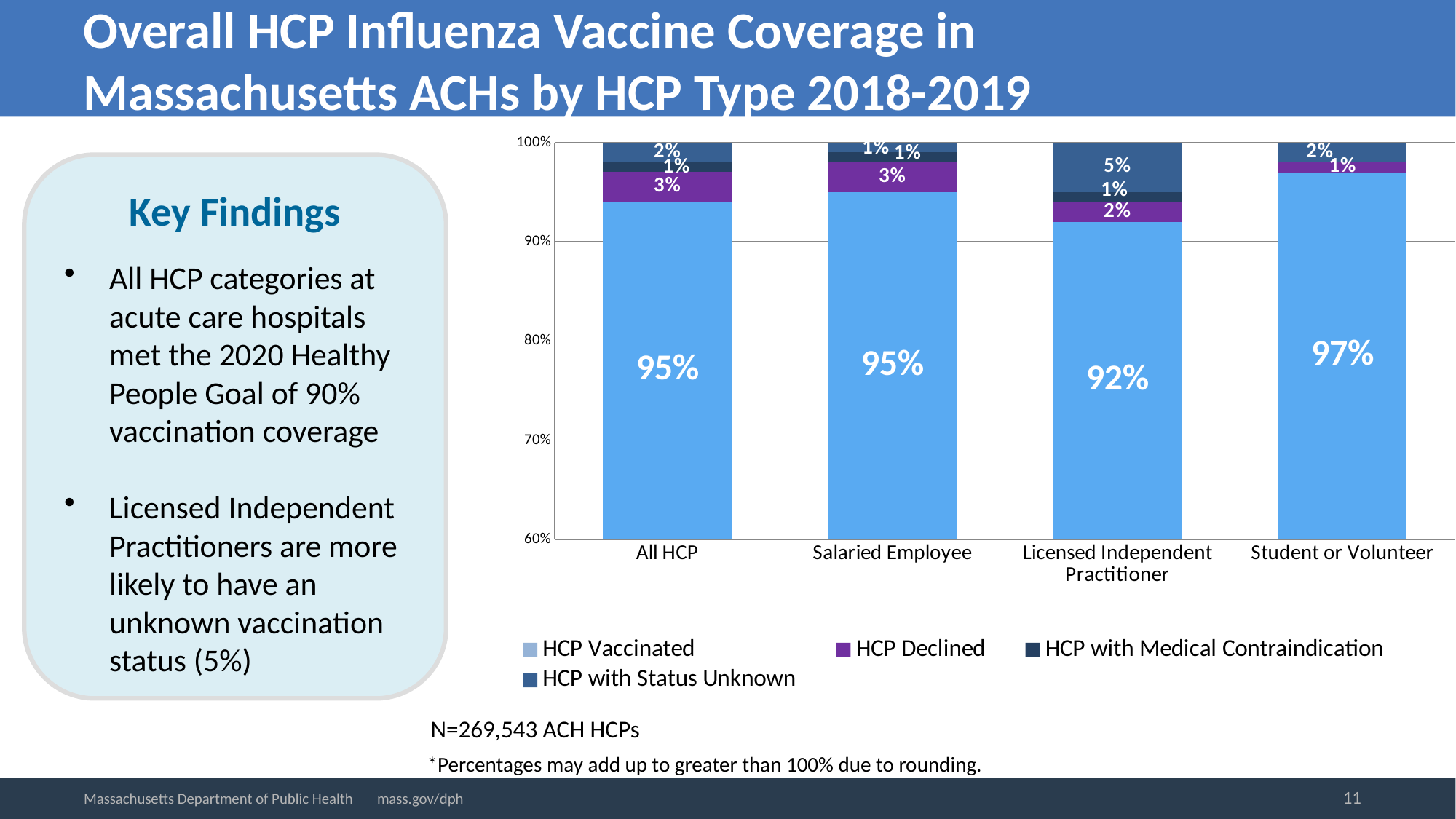
How many percentage points higher is the HCP Vaccinated value for Student or Volunteer than for Licensed Independent Practitioner? 5 percentage points Which HCP type has the highest HCP Vaccinated percentage? Student or Volunteer What is the HCP Vaccinated value for Student or Volunteer? 97% What is the lowest value shown on the y axis of the chart? 60% What kind of chart is shown on the slide? Stacked bar chart How many HCP type categories are shown on the x axis? 4 Which HCP type has the lowest HCP Vaccinated percentage? Licensed Independent Practitioner Which has a higher HCP Vaccinated percentage, Salaried Employee or Licensed Independent Practitioner? Salaried Employee What is the HCP with Status Unknown value for Licensed Independent Practitioner? 5% What percentage of Licensed Independent Practitioners were vaccinated (HCP Vaccinated)? 92% What is the HCP Declined value for All HCP? 3% How many series does the legend list? 4